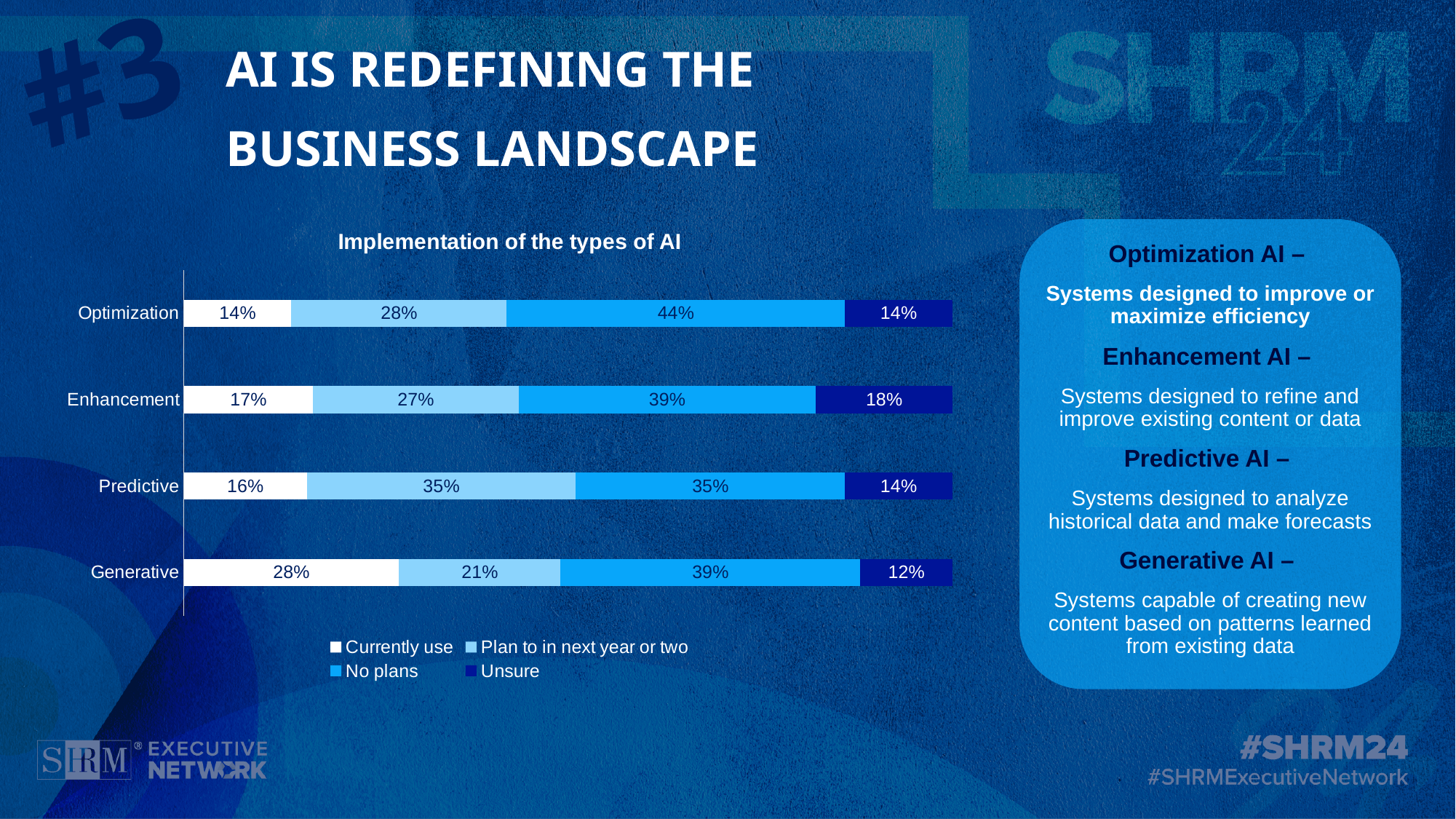
How many series does the legend list? 4 What is the difference between the 'Currently use' values for Generative and Optimization AI? 14% Is the 'No plans' value larger for Optimization or Enhancement AI? Optimization What is the title of the chart? Implementation of the types of AI What is the 'No plans' value for Optimization AI? 44% What is the 'Plan to in next year or two' value for Predictive AI? 35% Which type of AI has the highest 'Currently use' percentage? Generative What is the 'Unsure' value for Enhancement AI? 18% What percentage of respondents currently use Generative AI? 28% How many types of AI are shown in the chart? 4 Which type of AI has the lowest 'Unsure' percentage? Generative What kind of chart is shown on the slide? Stacked bar chart